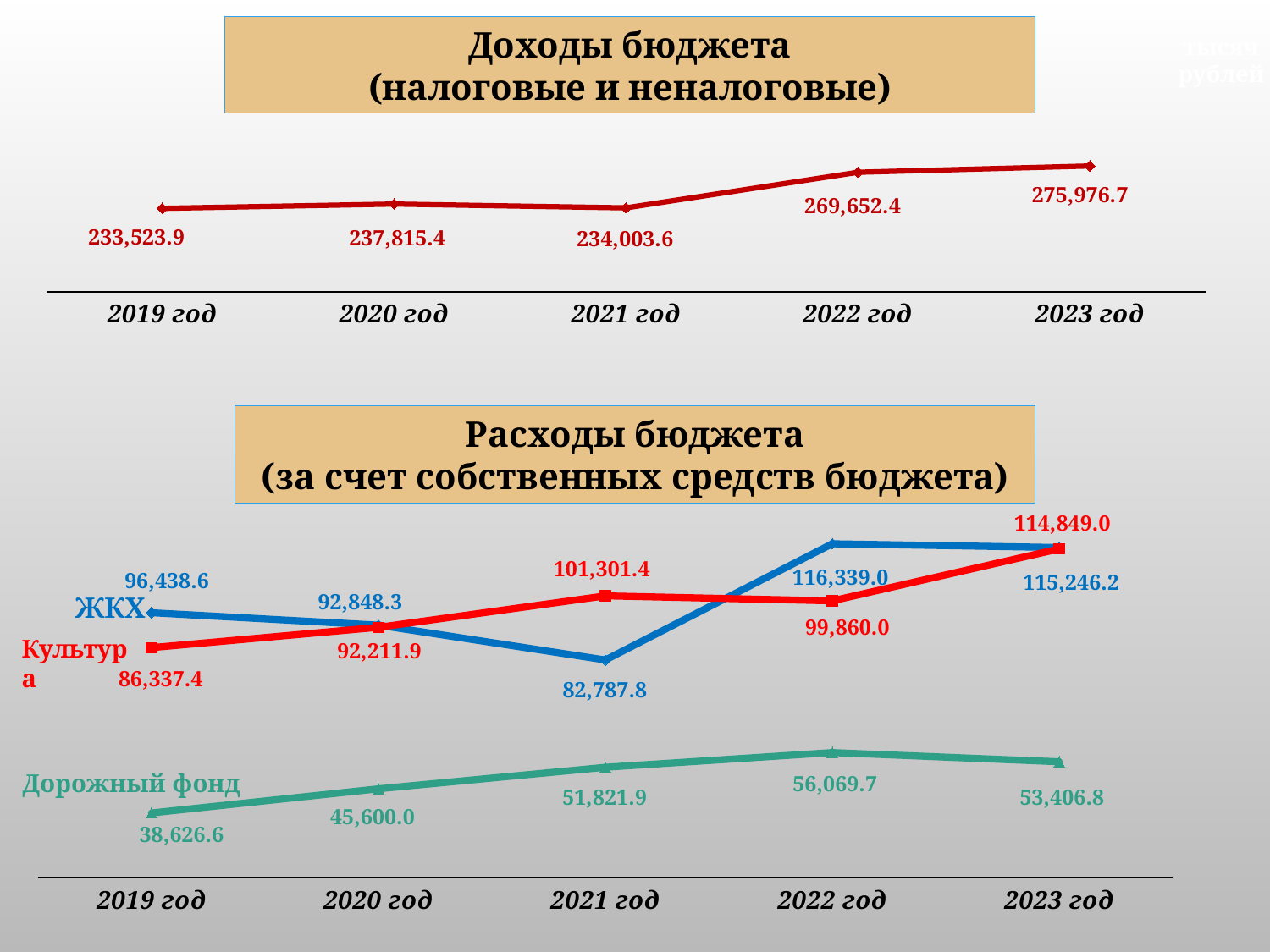
In the chart titled "Расходы бюджета (за счет собственных средств бюджета)", what is the difference between the Культура values for 2023 год and 2019 год? 28,511.6 In the chart titled "Расходы бюджета (за счет собственных средств бюджета)", which is larger in 2021 год: ЖКХ or Культура? Культура In the chart titled "Доходы бюджета (налоговые и неналоговые)", how many years are plotted? 5 How many series are plotted in the chart titled "Расходы бюджета (за счет собственных средств бюджета)"? 3 In the chart titled "Расходы бюджета (за счет собственных средств бюджета)", what is the value for ЖКХ in 2021 год? 82,787.8 In the chart titled "Доходы бюджета (налоговые и неналоговые)", what is the difference between the 2023 год and 2022 год values? 6,324.3 In the chart titled "Расходы бюджета (за счет собственных средств бюджета)", what is the value for Дорожный фонд in 2022 год? 56,069.7 What kind of chart is the top chart, "Доходы бюджета (налоговые и неналоговые)"? Line chart In the chart titled "Расходы бюджета (за счет собственных средств бюджета)", in which year is Дорожный фонд lowest? 2019 год In the chart titled "Доходы бюджета (налоговые и неналоговые)", what is the value for 2021 год? 234,003.6 In the chart titled "Доходы бюджета (налоговые и неналоговые)", which year has the lowest value? 2019 год In the chart titled "Доходы бюджета (налоговые и неналоговые)", which year has the highest value? 2023 год